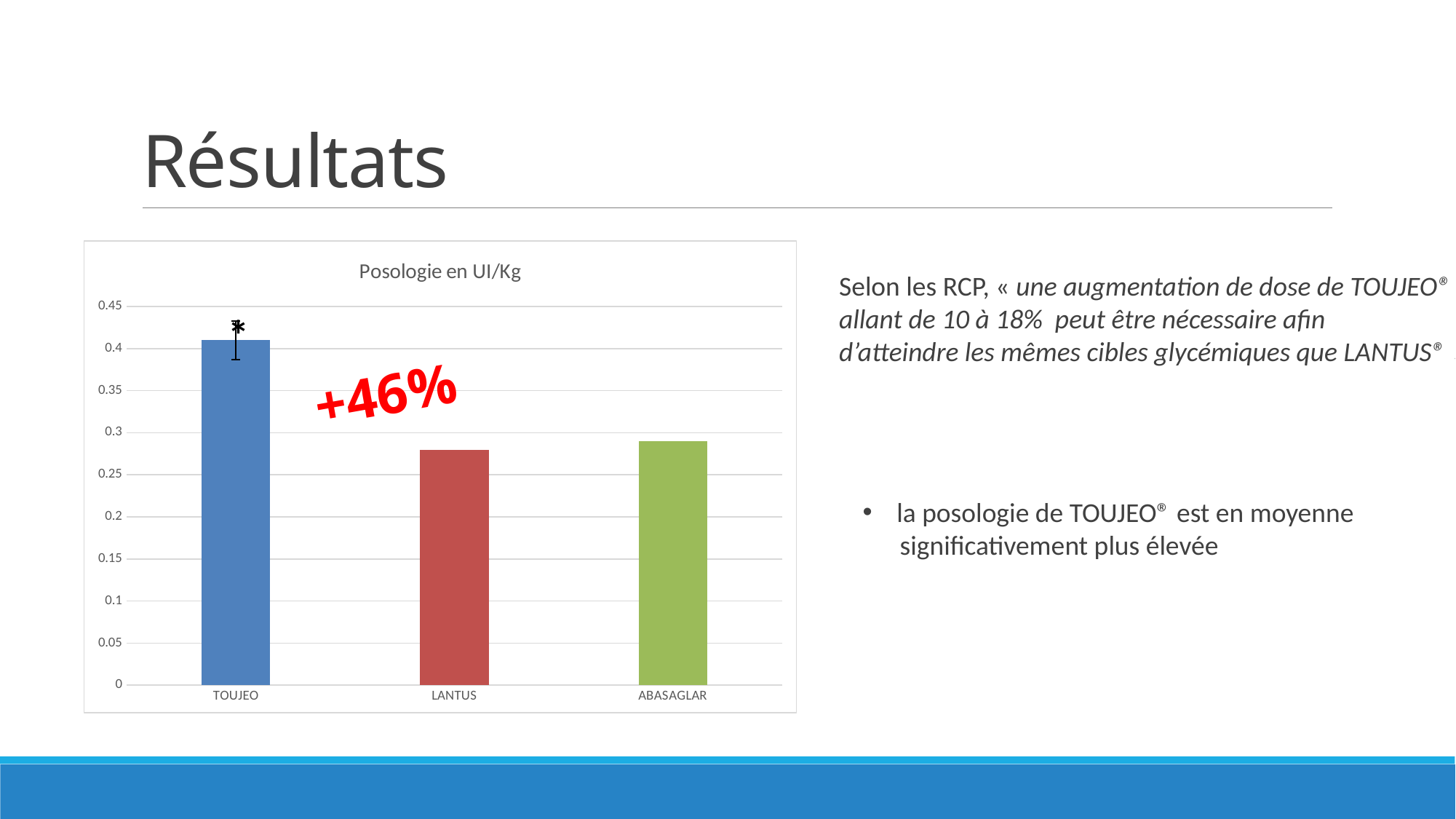
How many categories are plotted in the chart? 3 Which is larger, the value for TOUJEO or the value for ABASAGLAR? TOUJEO What percentage annotation is written in red on the chart? +46% Is the value for TOUJEO greater or less than 0.35? greater Is the value for LANTUS greater or less than 0.3? less Which category has the highest value in the chart? TOUJEO Which is larger, the value for TOUJEO or the value for LANTUS? TOUJEO What kind of chart is shown on the slide? bar chart What is the title of the chart? Posologie en UI/Kg What is the highest value shown on the vertical axis of the chart? 0.45 Is the value for LANTUS greater or less than 0.25? greater